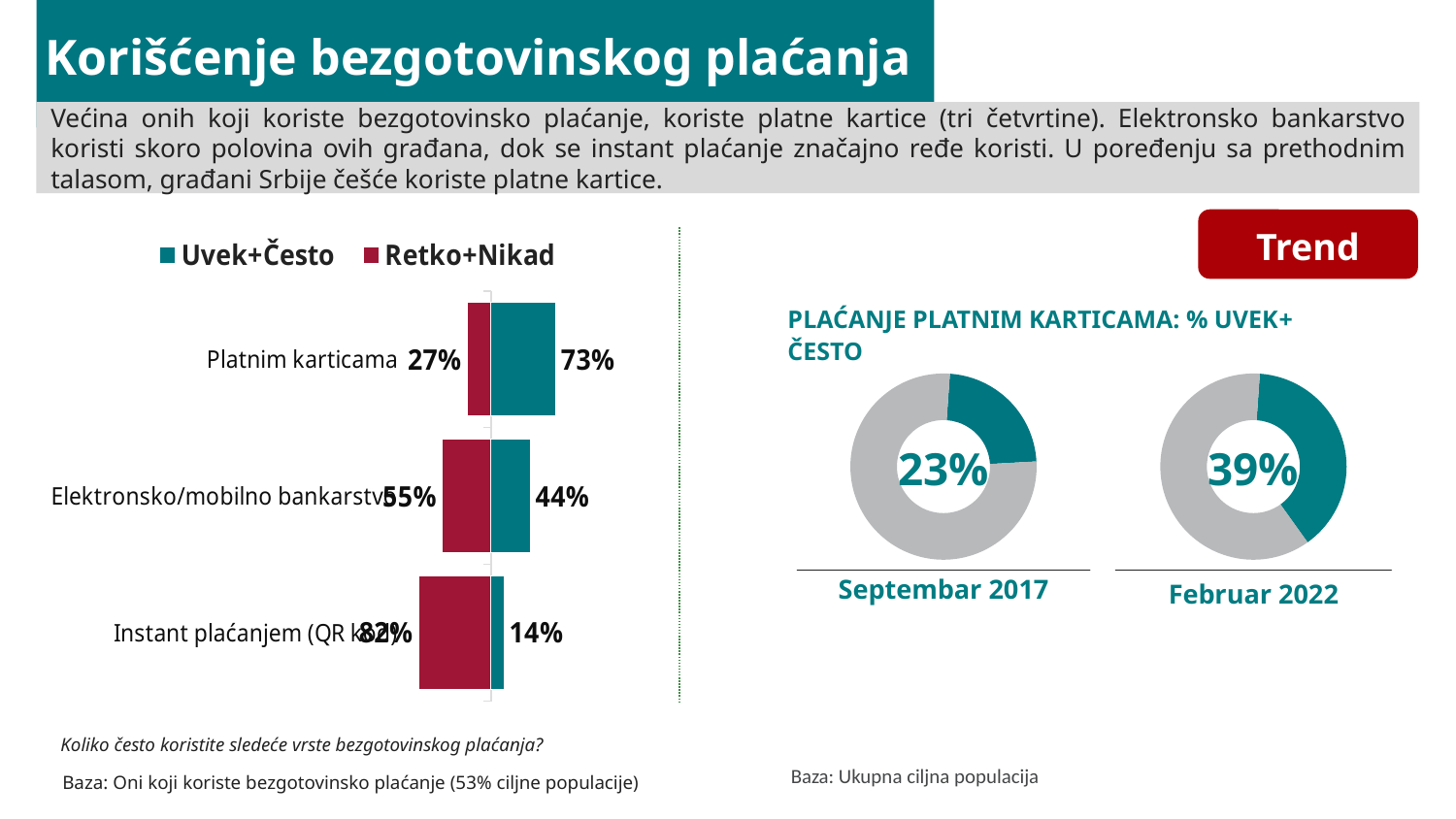
In the bar chart on the left, is the Retko+Nikad value larger for Instant plaćanjem (QR kod) or for Platnim karticama? Instant plaćanjem (QR kod) In the bar chart on the left, which category has the lowest Uvek+Često value? Instant plaćanjem (QR kod) In the Trend section on the right, what is the value shown for Februar 2022? 39% In the bar chart on the left, what is the Uvek+Često value for Instant plaćanjem (QR kod)? 14% In the Trend section on the right, what is the difference between the Februar 2022 and Septembar 2017 values? 16% What kind of chart is used on the left side of the slide? Bar chart In the bar chart on the left, what is the Retko+Nikad value for Elektronsko/mobilno bankarstvo? 55% In the bar chart on the left, what is the difference between the Uvek+Često values for Platnim karticama and Elektronsko/mobilno bankarstvo? 29% How many categories does the bar chart on the left show? 3 How many series does the legend of the bar chart on the left list? 2 In the bar chart on the left, what is the Uvek+Često value for Platnim karticama? 73% In the bar chart on the left, which category has the highest Uvek+Često value? Platnim karticama